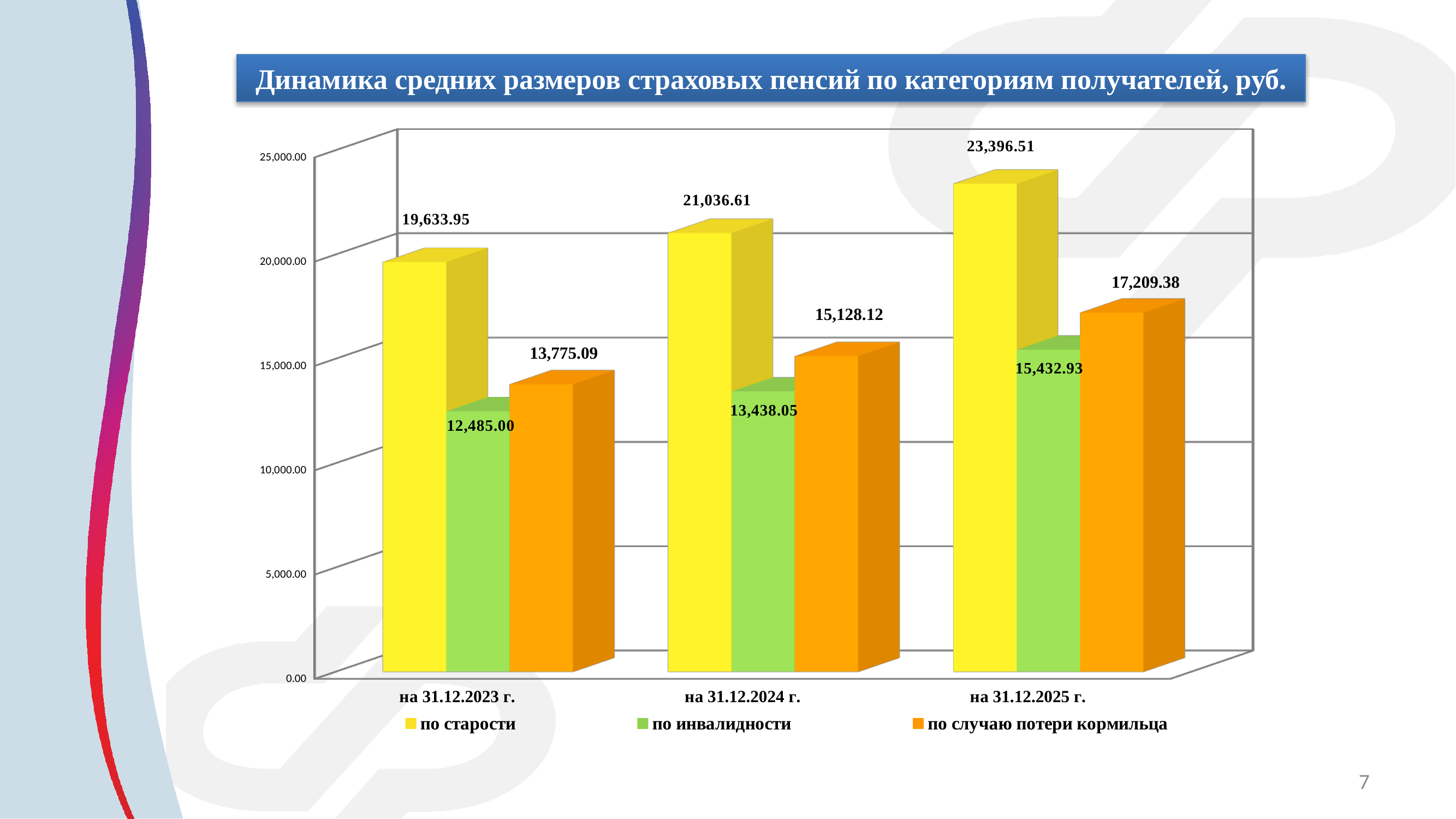
How many series does the legend list? 3 At which date is the value for «по старости» highest? на 31.12.2025 г. What is the value for «по инвалидности» at «на 31.12.2024 г.»? 13,438.05 What is the value for «по случаю потери кормильца» at «на 31.12.2025 г.»? 17,209.38 Do the values for «по случаю потери кормильца» rise or fall from «на 31.12.2023 г.» to «на 31.12.2025 г.»? Rise What is the value for «по старости» at «на 31.12.2023 г.»? 19,633.95 What is the difference between the «по старости» values at «на 31.12.2025 г.» and «на 31.12.2023 г.»? 3,762.56 Which is larger at «на 31.12.2024 г.»: «по инвалидности» or «по случаю потери кормильца»? по случаю потери кормильца What is the difference between the «по случаю потери кормильца» values at «на 31.12.2025 г.» and «на 31.12.2023 г.»? 3,434.29 How many dates (categories) are shown on the x axis? 3 At which date is the value for «по инвалидности» lowest? на 31.12.2023 г. What kind of chart is shown on the slide? Bar chart